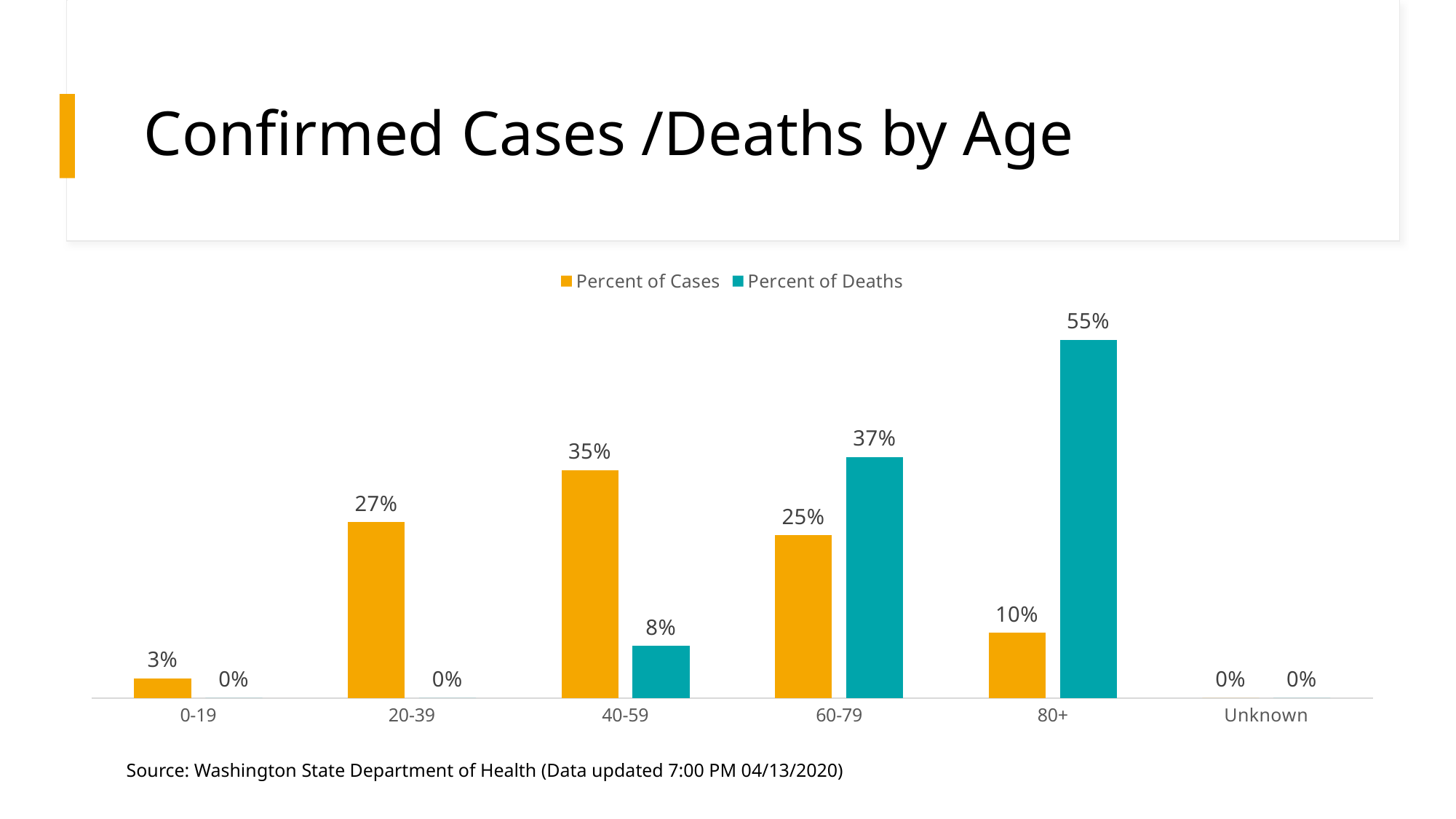
What is the difference between Percent of Deaths and Percent of Cases for the 80+ age group? 45% What kind of chart is shown on the slide? Bar chart What is the Percent of Deaths for the 60-79 age group? 37% Which age group has the highest Percent of Cases? 40-59 Which age group has the highest Percent of Deaths? 80+ What is the Percent of Cases for the 40-59 age group? 35% Which colour represents Percent of Deaths in the legend? Teal What is the Percent of Cases for the 0-19 age group? 3% How many age categories are shown on the x axis? 6 How many series does the legend list? 2 Which is larger for the 20-39 age group, Percent of Cases or Percent of Deaths? Percent of Cases What is the Percent of Deaths for the 80+ age group? 55%